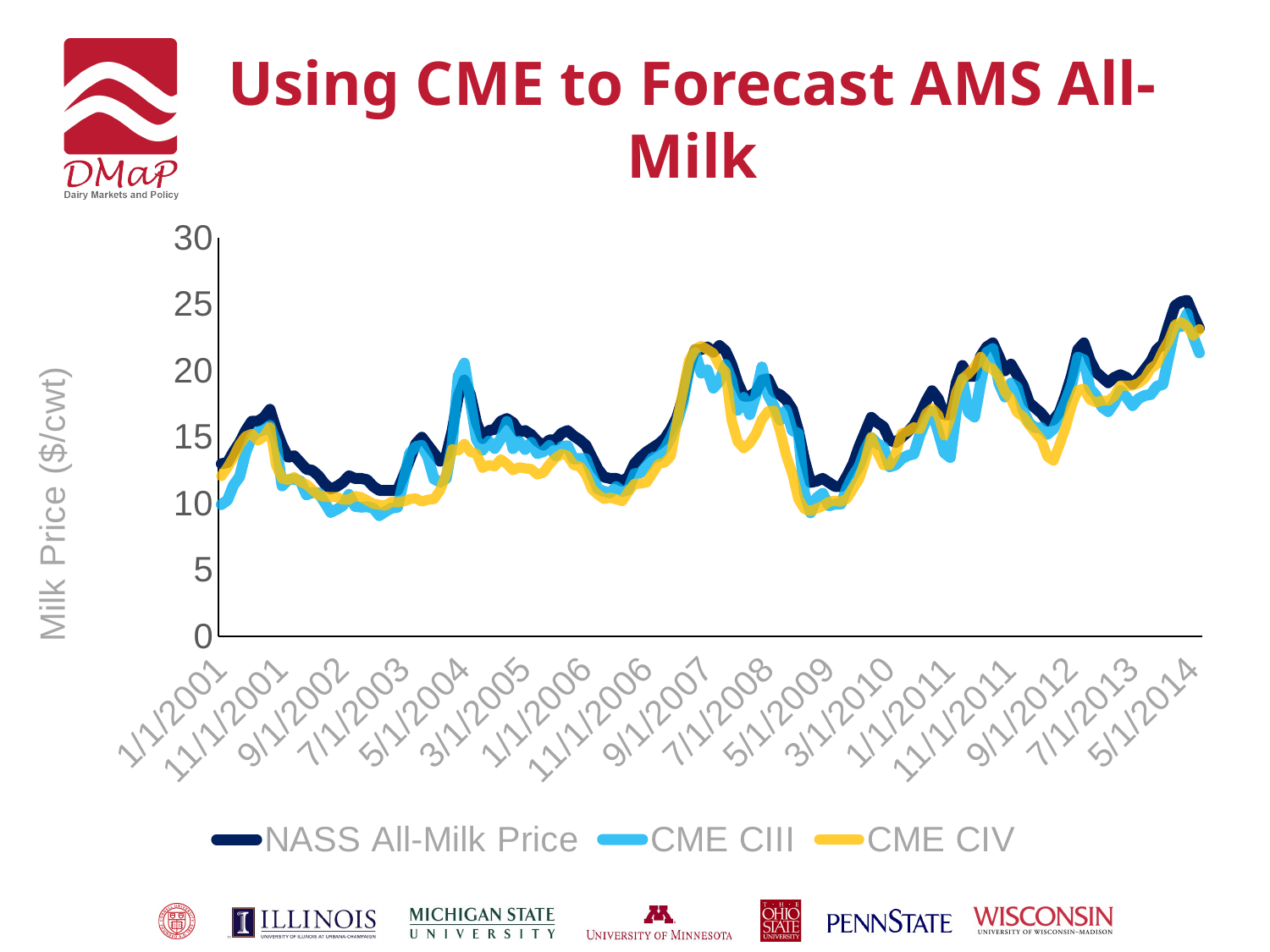
Is the value of CME CIV around 9/1/2007 greater or less than 20? greater What is the label on the vertical axis? Milk Price ($/cwt) Is the value of CME CIII around 9/1/2002 greater or less than 15? less Which series reaches the highest value anywhere on the chart? NASS All-Milk Price Is the value of the NASS All-Milk Price around 5/1/2009 greater or less than 15? less What are the three series named in the legend? NASS All-Milk Price, CME CIII, CME CIV What kind of chart is shown on the slide? line chart What is the highest tick value shown on the vertical axis? 30 Over the whole period from 1/1/2001 to 5/1/2014, do the plotted prices generally rise or fall? rise How many series does the legend list? 3